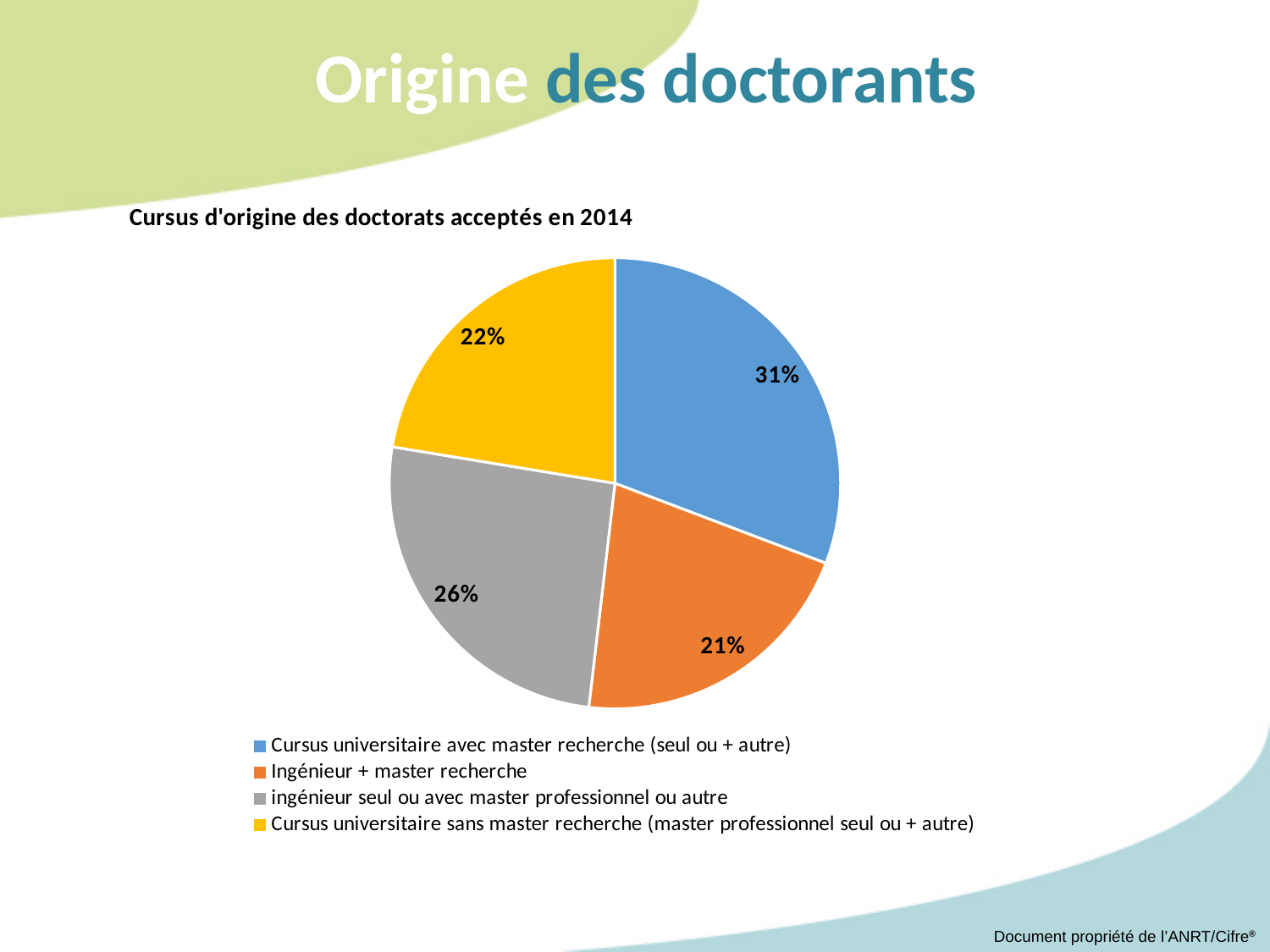
How many categories does the pie chart have? 4 Which category has the largest share of the pie? Cursus universitaire avec master recherche (seul ou + autre) Which category has the smallest share of the pie? Ingénieur + master recherche What is the title of the chart? Cursus d'origine des doctorats acceptés en 2014 What share of the pie is 'Cursus universitaire avec master recherche (seul ou + autre)'? 31% What type of chart is shown on the slide? pie chart What colour is the slice for 'Ingénieur + master recherche'? orange What share of the pie is 'Ingénieur + master recherche'? 21% What share of the pie is 'Cursus universitaire sans master recherche (master professionnel seul ou + autre)'? 22% What share of the pie is 'ingénieur seul ou avec master professionnel ou autre'? 26% What is the difference in percentage points between 'Cursus universitaire avec master recherche (seul ou + autre)' and 'Ingénieur + master recherche'? 10 Which is larger: the share for 'ingénieur seul ou avec master professionnel ou autre' or the share for 'Cursus universitaire sans master recherche (master professionnel seul ou + autre)'? ingénieur seul ou avec master professionnel ou autre